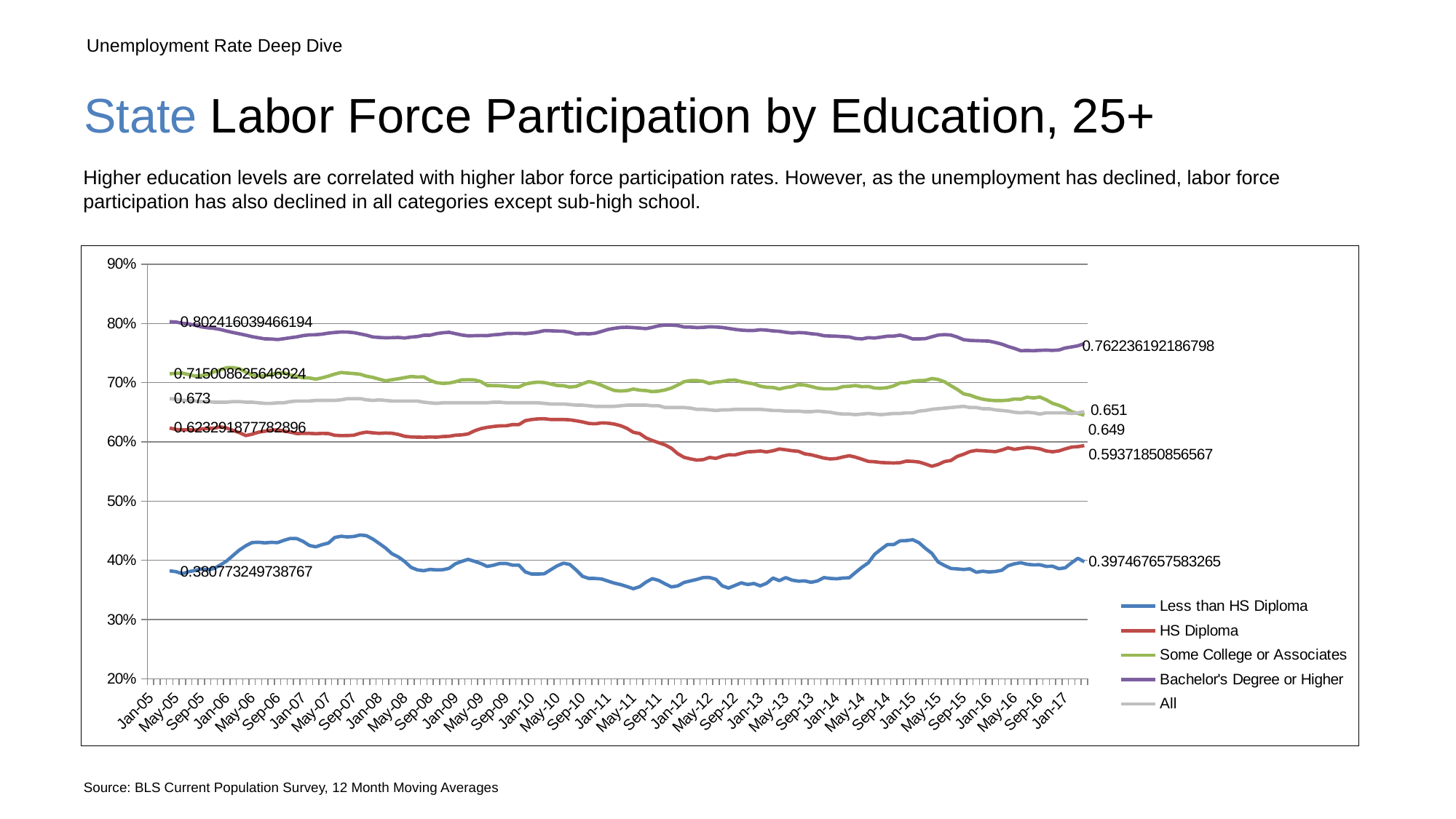
What is the last labelled value for the HS Diploma series at the right end of the chart? 0.59371850856567 What colour is the HS Diploma line in the legend? Red How many series does the legend list? 5 What is the last labelled value for the Less than HS Diploma series at the right end of the chart? 0.397467657583265 Which series has the lowest labor force participation rate across the chart? Less than HS Diploma What is the last labelled value for the Bachelor's Degree or Higher series at the right end of the chart? 0.762236192186798 Is the Less than HS Diploma value around May-11 greater or less than 40%? less What is the first labelled value for the Bachelor's Degree or Higher series? 0.802416039466194 What kind of chart is shown on the slide? Line chart What is the first labelled value for the All series? 0.673 What is the first labelled value for the Less than HS Diploma series? 0.380773249738767 Which series has the highest labor force participation rate across the chart? Bachelor's Degree or Higher